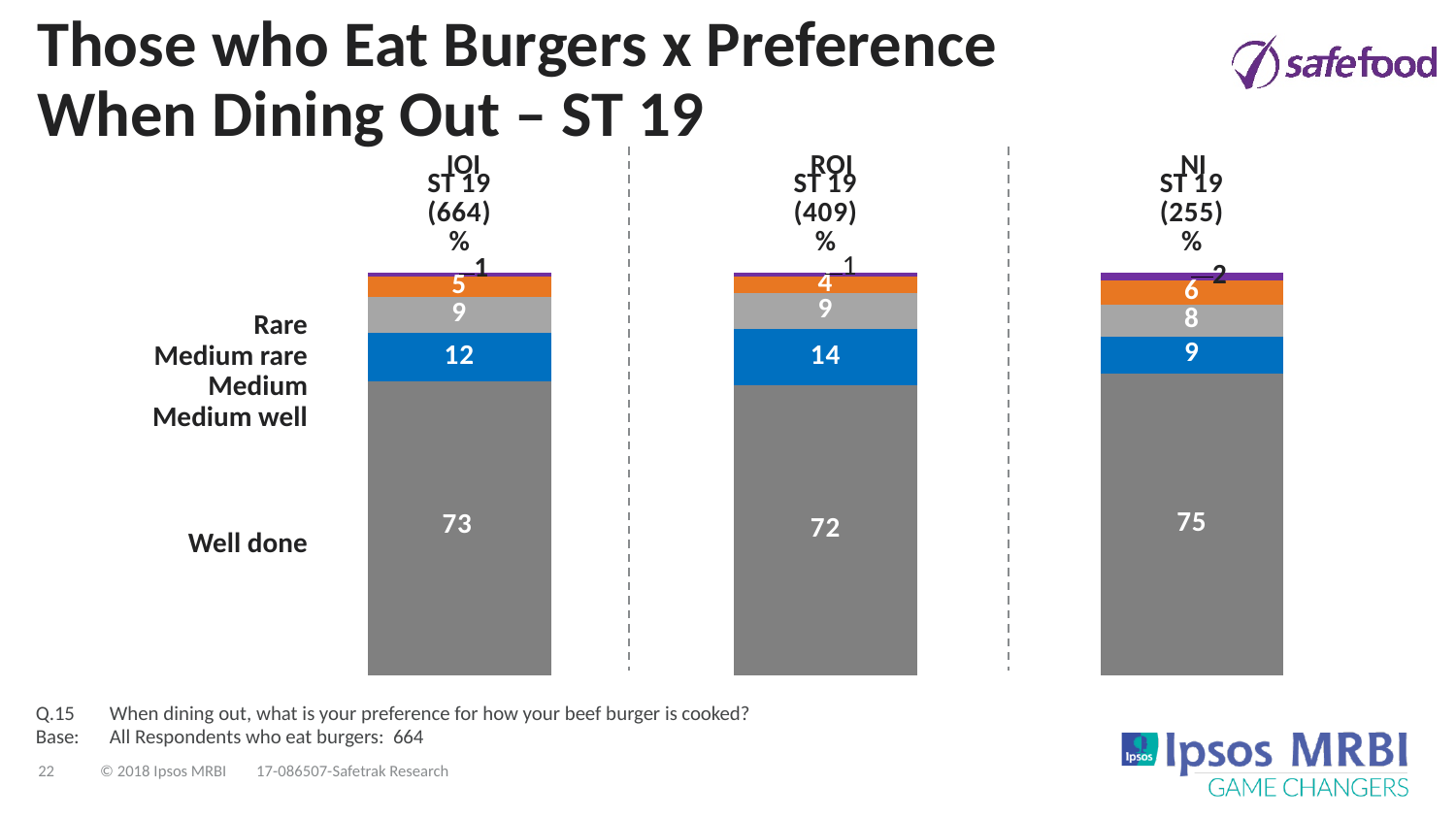
Which region has the lowest percentage preferring Medium well? NI Which region has the highest percentage preferring Well done? NI What is the value for Medium rare in the NI bar? 6 What is the value for Well done in the NI bar? 75 What is the base size shown for the ROI bar? 409 What percentage of IOI respondents prefer their burger well done? 73 How many stacked bars are shown on the slide? 3 What is the difference between the Medium well values for ROI and IOI? 2 Is the Medium value larger for IOI or NI? IOI What kind of chart is shown on the slide? Stacked bar chart What is the value for Medium well in the ROI bar? 14 What is the total of the segments in the IOI bar? 100